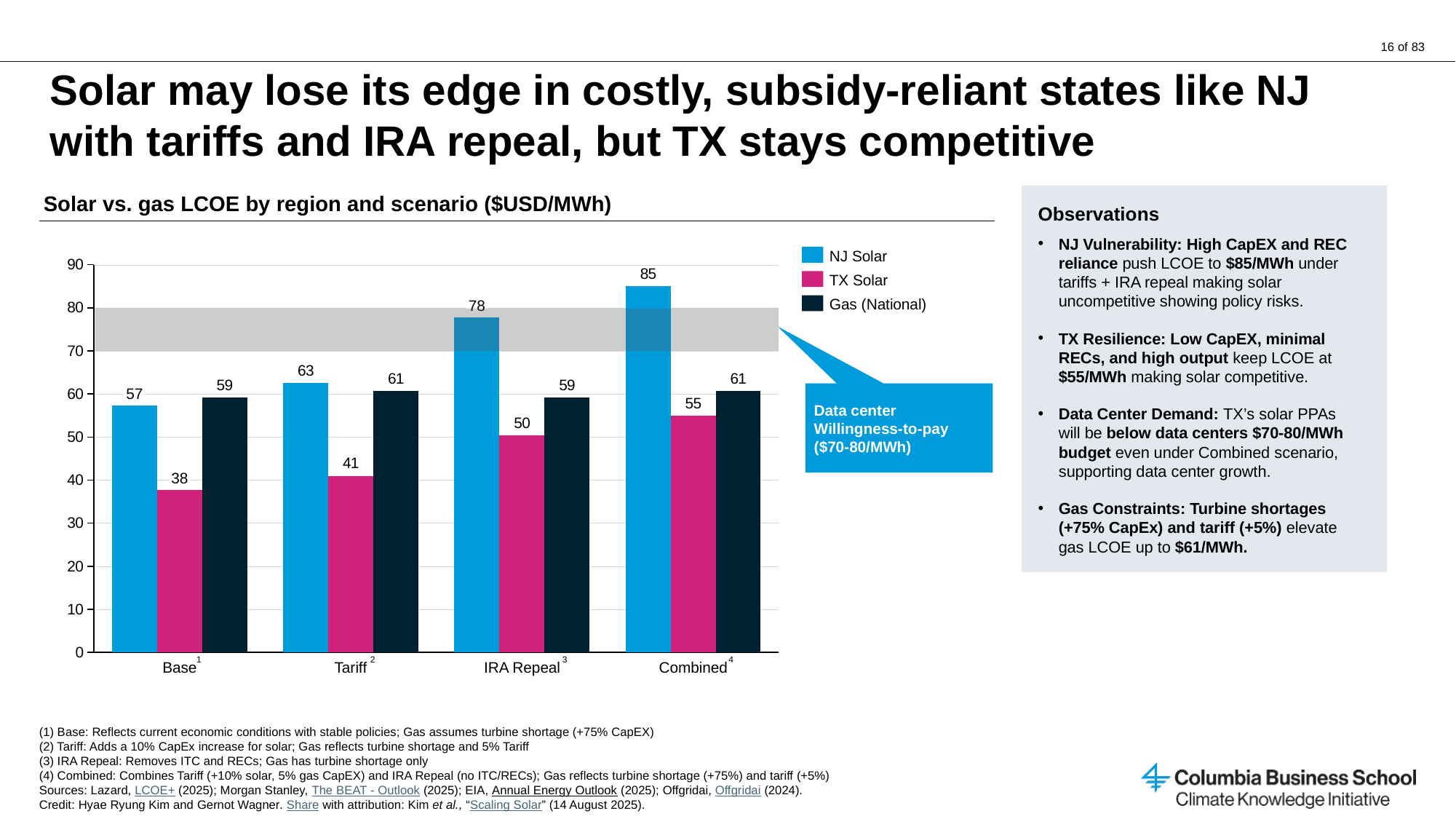
Is the NJ Solar value in the IRA Repeal scenario greater or less than 70? greater What is the TX Solar LCOE value in the Base scenario? 38 What is the NJ Solar LCOE value in the Combined scenario? 85 What kind of chart is shown on the slide? Bar chart How many series does the legend list? 3 Which scenario has the lowest TX Solar value? Base What is the difference between NJ Solar and TX Solar in the IRA Repeal scenario? 28 What range does the grey shaded band labelled 'Data center Willingness-to-pay' cover? $70-80/MWh In the Tariff scenario, which is larger: NJ Solar or Gas (National)? NJ Solar How many scenarios are shown on the x axis? 4 Which scenario has the highest NJ Solar value? Combined What is the Gas (National) LCOE value in the Tariff scenario? 61